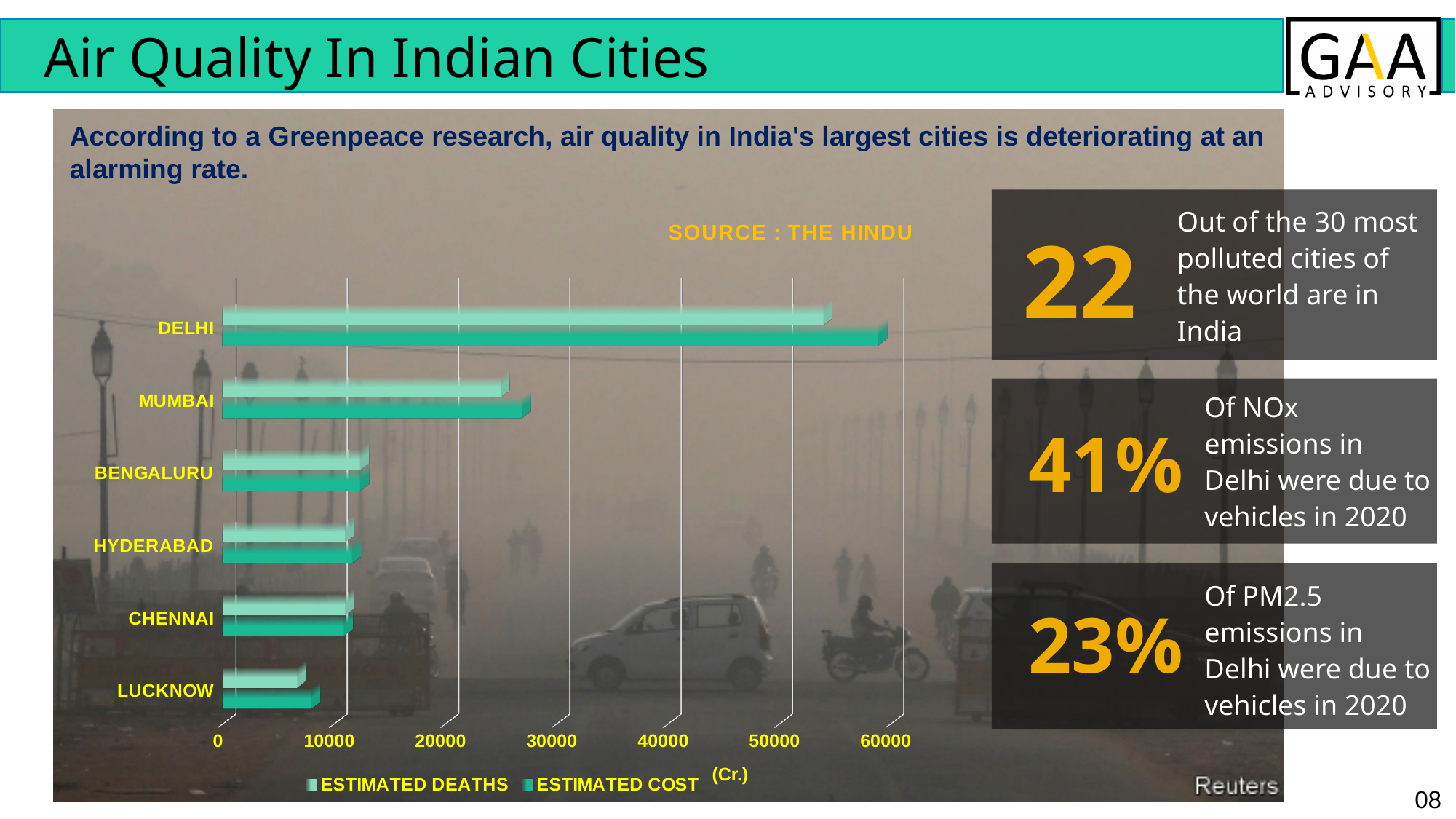
Which city has the lowest estimated deaths? Lucknow How many series does the chart legend list? 2 Is the estimated cost for Delhi greater or less than 50000? greater What kind of chart is shown on the slide? Bar chart How many cities are shown on the chart? 6 Is the estimated cost for Bengaluru greater or less than 10000? greater What source is cited for the chart? The Hindu Is the estimated deaths value for Mumbai greater or less than 30000? less Which city has the larger estimated cost, Delhi or Mumbai? Delhi What are the two series named in the chart legend? Estimated Deaths and Estimated Cost Which city has the highest estimated cost? Delhi